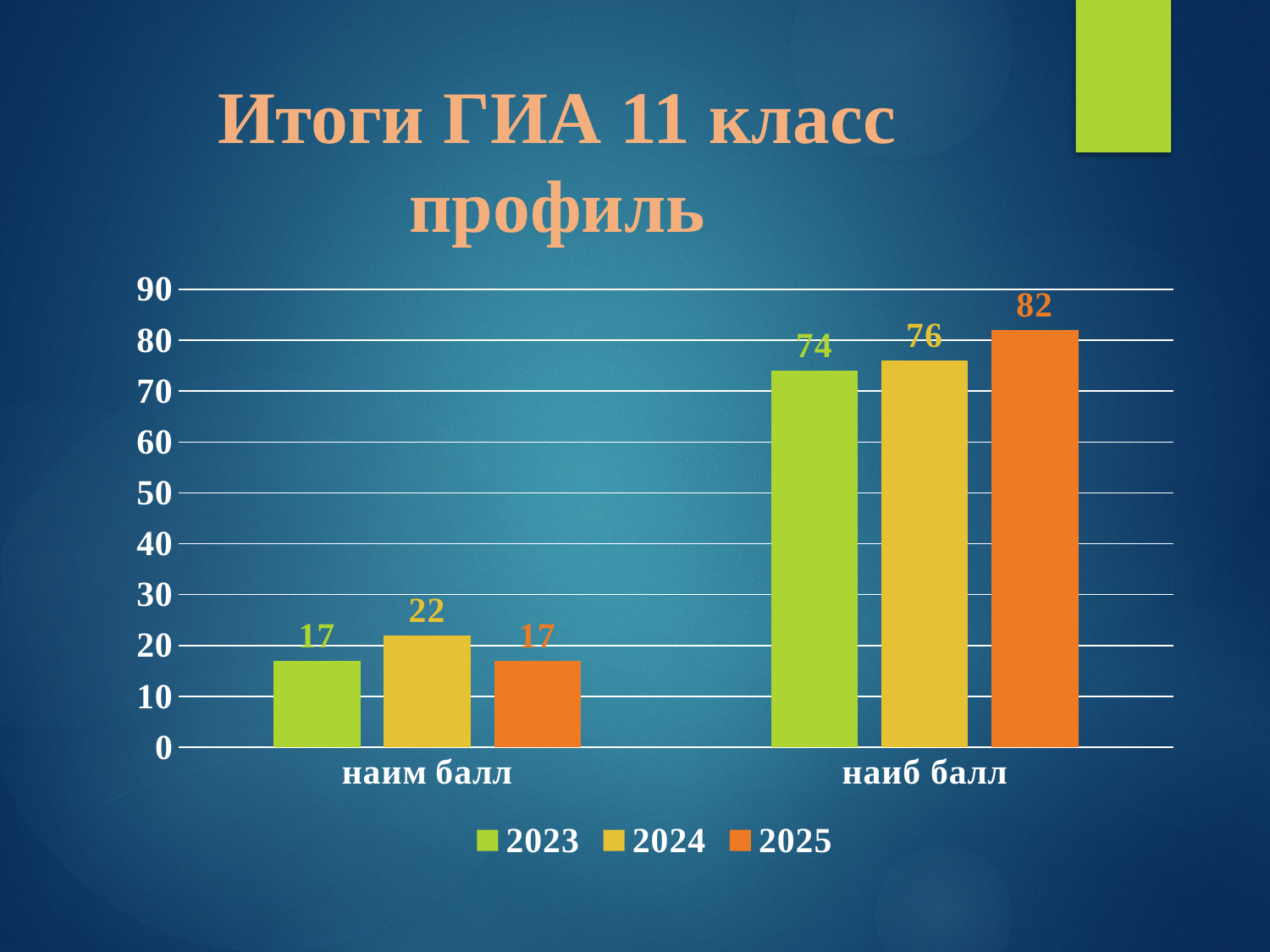
What kind of chart is shown on the slide? bar chart Which year has the highest value in the "наиб балл" category? 2025 What is the value for 2024 in the "наим балл" category? 22 How many series does the legend list? 3 Which is larger: the 2024 value for "наиб балл" or the 2023 value for "наиб балл"? 2024 What is the difference between the 2024 and 2025 values in the "наим балл" category? 5 What is the value for 2023 in the "наиб балл" category? 74 What is the difference between the 2025 and 2023 values in the "наиб балл" category? 8 What is the title of the chart on the slide? Итоги ГИА 11 класс профиль What is the value for 2025 in the "наиб балл" category? 82 Which year has the highest value in the "наим балл" category? 2024 How many categories are shown on the x axis? 2